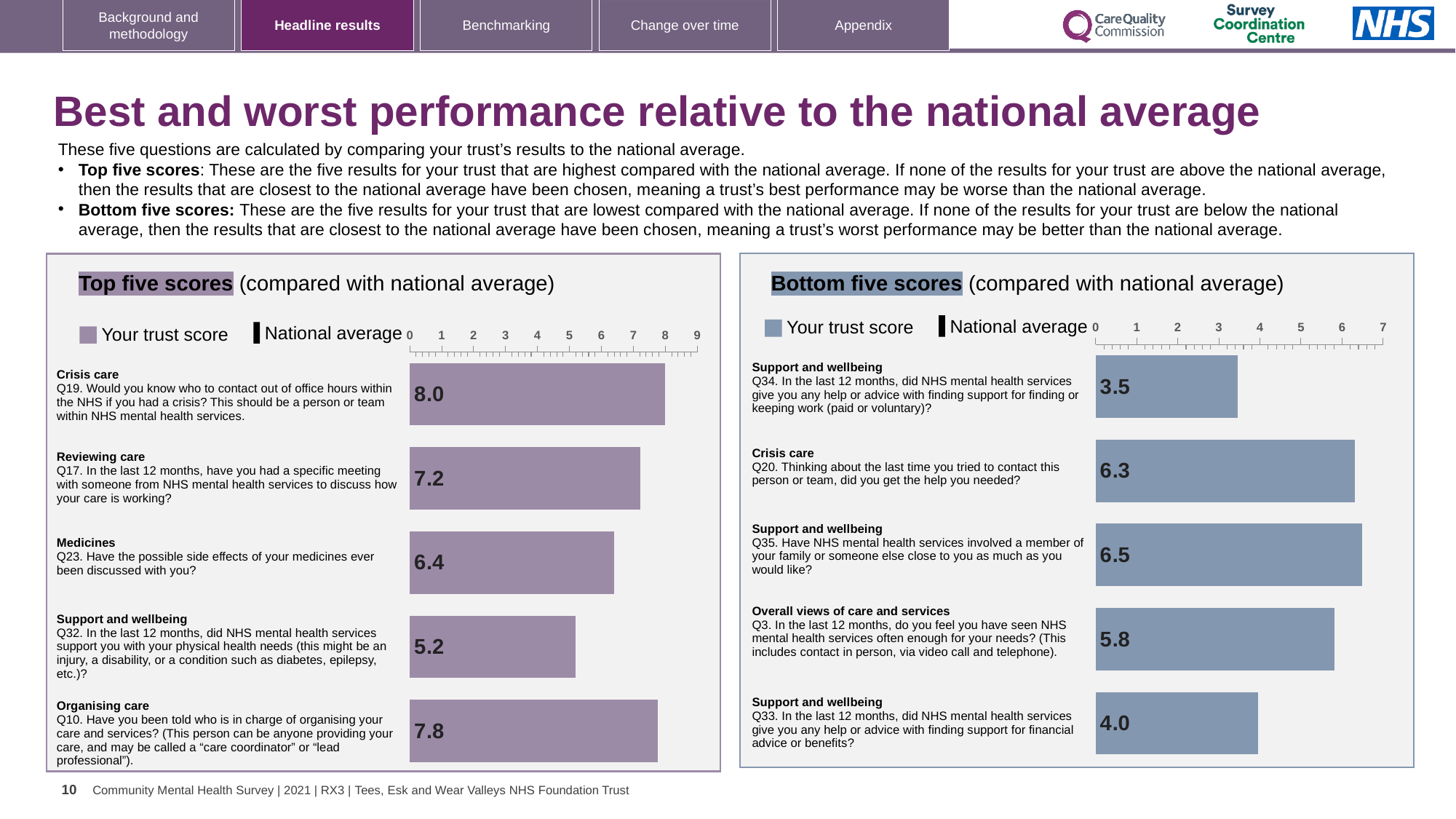
In the Bottom five scores chart, which question has the highest trust score? Q35 (Support and wellbeing) In the Top five scores chart, what is the trust score for Crisis care (Q19)? 8.0 What type of chart is the Top five scores chart? Bar chart In the Top five scores chart, what is the difference between the scores for Crisis care (Q19) and Reviewing care (Q17)? 0.8 How many bars are shown in the Bottom five scores chart? 5 In the Bottom five scores chart, which question has the lowest trust score? Q34 (Support and wellbeing) In the Top five scores chart, which is larger: the score for Organising care (Q10) or Reviewing care (Q17)? Organising care (Q10) In the Bottom five scores chart, what is the trust score for Crisis care (Q20)? 6.3 In the Top five scores chart, which question has the lowest trust score? Q32 (Support and wellbeing) In the Top five scores chart, what is the trust score for Medicines (Q23)? 6.4 In the Bottom five scores chart, what is the trust score for Q33 on financial advice or benefits? 4.0 In the Bottom five scores chart, what is the difference between the scores for Q3 and Q34? 2.3